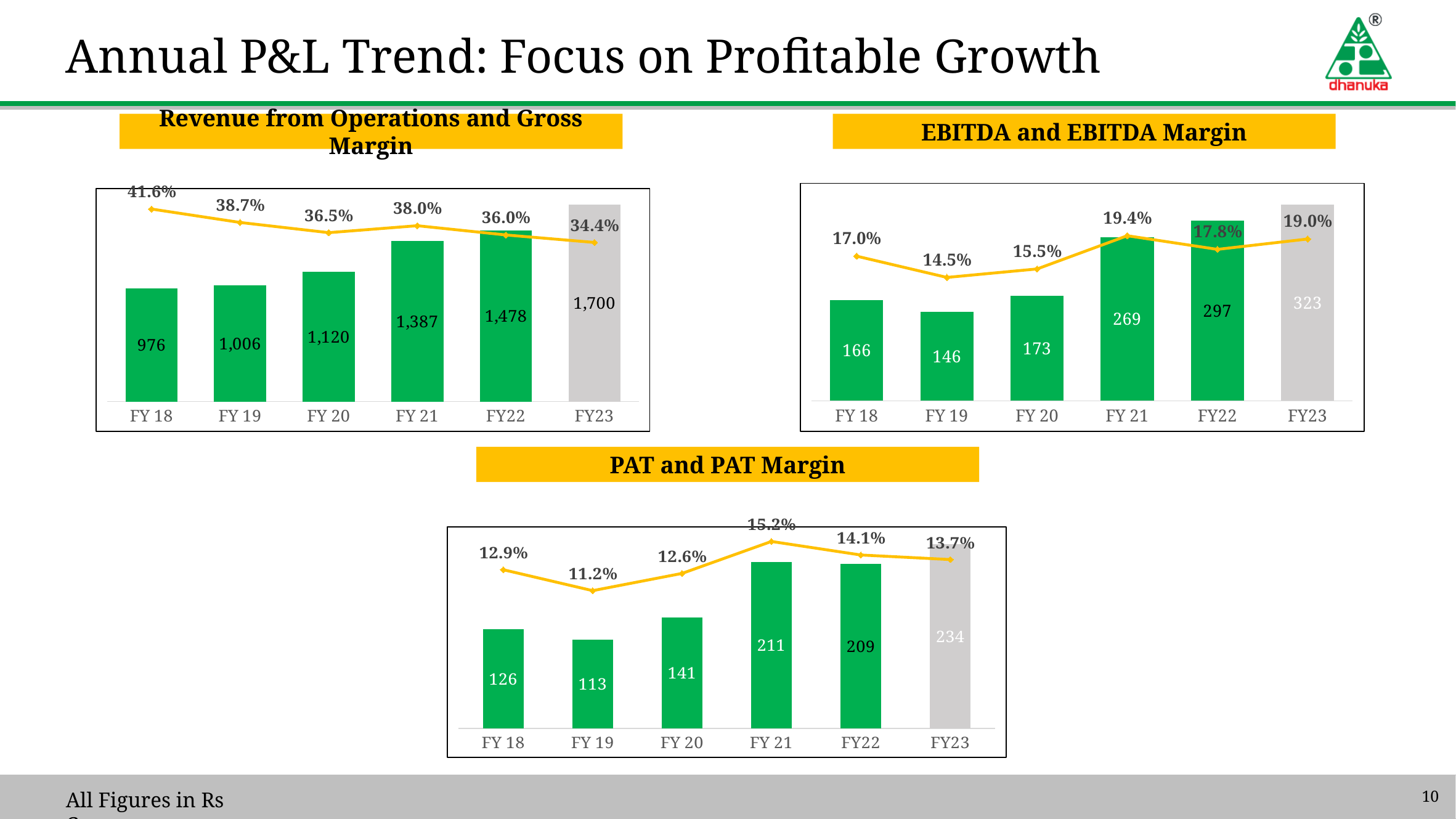
In the 'Revenue from Operations and Gross Margin' chart, what is the gross margin for FY 18? 41.6% In the 'EBITDA and EBITDA Margin' chart, what is the EBITDA value for FY 19? 146 In the 'PAT and PAT Margin' chart, which is larger, the PAT for FY 21 or for FY22? FY 21 In the 'EBITDA and EBITDA Margin' chart, which year has the lowest EBITDA bar? FY 19 How many years are shown on the x axis of the 'PAT and PAT Margin' chart? 6 In the 'Revenue from Operations and Gross Margin' chart, what is the revenue value for FY 21? 1,387 In the 'EBITDA and EBITDA Margin' chart, which year has the highest EBITDA margin? FY 21 In the 'PAT and PAT Margin' chart, what is the PAT value for FY23? 234 In the 'PAT and PAT Margin' chart, what is the PAT margin for FY 19? 11.2% In the 'Revenue from Operations and Gross Margin' chart, which year has the highest revenue bar? FY23 In the 'Revenue from Operations and Gross Margin' chart, what is the difference in revenue between FY23 and FY22? 222 What kind of chart is the 'EBITDA and EBITDA Margin' chart? Bar chart with a line